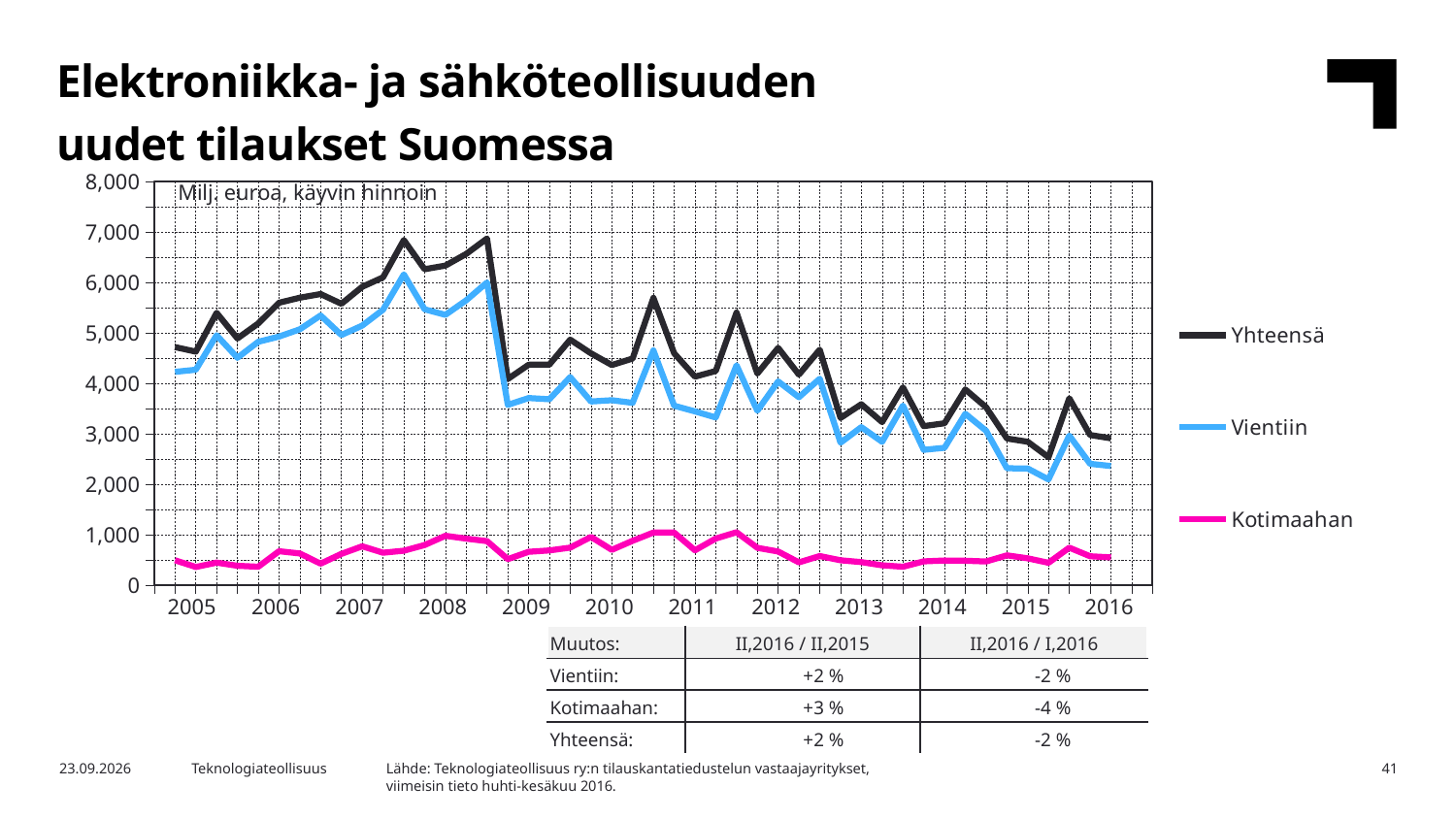
Is the peak value for Yhteensä in 2008 greater or less than 6,000? greater How many series does the legend list? 3 What unit is stated in the label inside the chart area? Milj. euroa, käyvin hinnoin Is the value for Vientiin at the end of 2016 greater or less than 3,000? less Which series has the highest values throughout the chart? Yhteensä Which series has the lowest values throughout the chart? Kotimaahan Is the value for Yhteensä at the start of 2005 greater or less than 4,000? greater What are the three series named in the legend? Yhteensä, Vientiin, Kotimaahan Which is larger in 2016, the value for Vientiin or the value for Kotimaahan? Vientiin What kind of chart is shown on the slide? line chart Does the Yhteensä series rise or fall between 2008 and 2009? fall